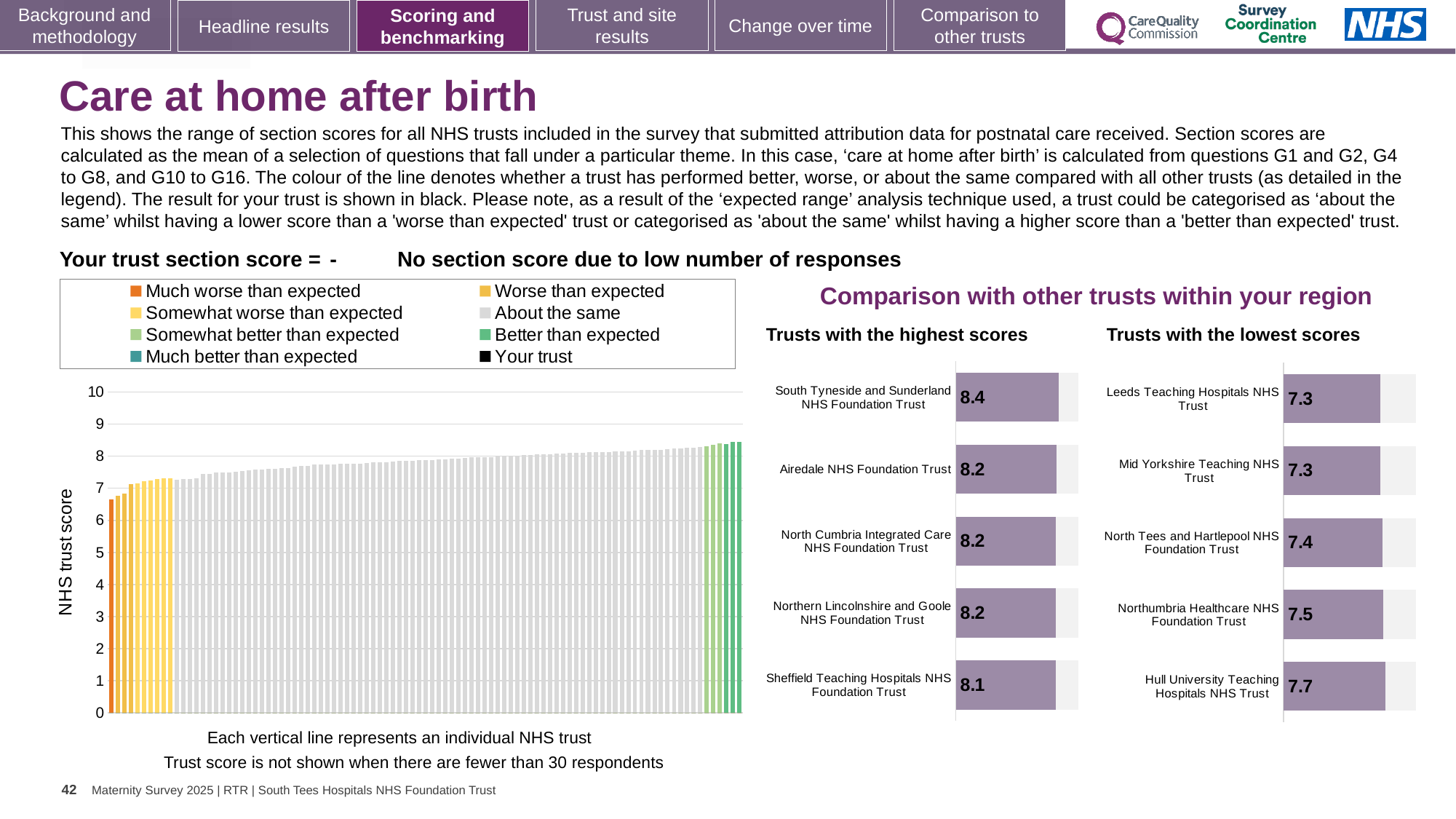
In the 'Trusts with the lowest scores' chart, what is the score for Hull University Teaching Hospitals NHS Trust? 7.7 How many entries does the legend above the large 'NHS trust score' chart list? 8 In the large 'NHS trust score' chart on the left, do the bar values rise or fall from left to right? rise In the large 'NHS trust score' chart on the left, is the value of the leftmost (lowest) bar greater or less than 7? less In the 'Trusts with the lowest scores' chart, what is the score for North Tees and Hartlepool NHS Foundation Trust? 7.4 In the 'Trusts with the lowest scores' chart, which trust has the highest score? Hull University Teaching Hospitals NHS Trust In the 'Trusts with the highest scores' chart, what is the score for South Tyneside and Sunderland NHS Foundation Trust? 8.4 In the 'Trusts with the lowest scores' chart, which has the larger score: Northumbria Healthcare NHS Foundation Trust or Mid Yorkshire Teaching NHS Trust? Northumbria Healthcare NHS Foundation Trust What is the difference between the score for South Tyneside and Sunderland NHS Foundation Trust in the highest scores chart and the score for Leeds Teaching Hospitals NHS Trust in the lowest scores chart? 1.1 How many trusts are listed in the 'Trusts with the highest scores' chart? 5 In the 'Trusts with the highest scores' chart, which trust has the highest score? South Tyneside and Sunderland NHS Foundation Trust In the 'Trusts with the highest scores' chart, what is the score for Sheffield Teaching Hospitals NHS Foundation Trust? 8.1